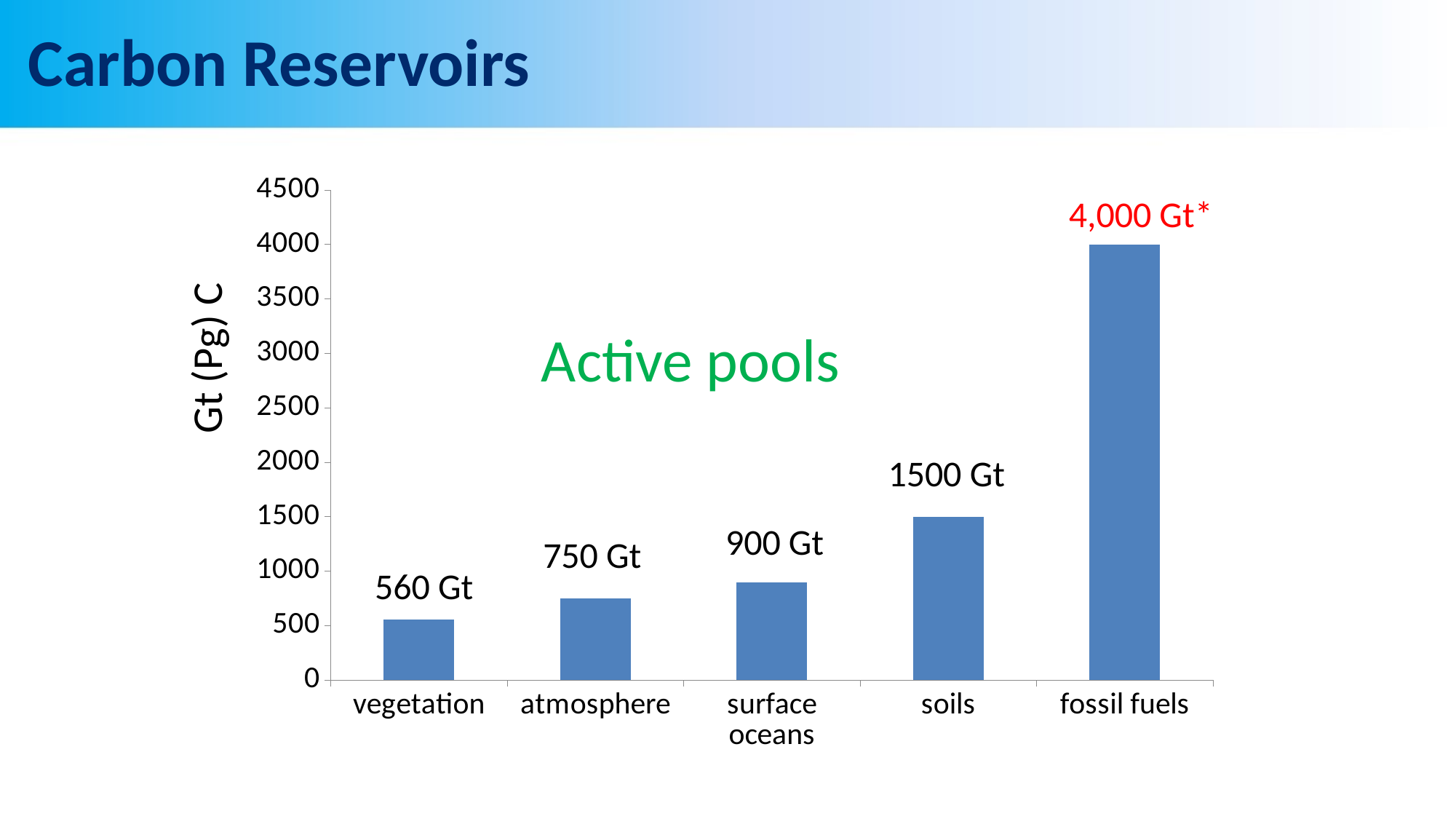
What kind of chart is shown on the slide? bar chart Which category has the highest value? fossil fuels What is the label on the vertical axis? Gt (Pg) C What is the value for soils? 1500 Gt What is the difference between the values for soils and surface oceans? 600 Gt What is the value for atmosphere? 750 Gt Which is larger, the value for atmosphere or the value for surface oceans? surface oceans Which category has the lowest value? vegetation What is the value for surface oceans? 900 Gt How many categories are shown on the x axis? 5 What is the value labelled for fossil fuels? 4,000 Gt* What is the value for vegetation? 560 Gt